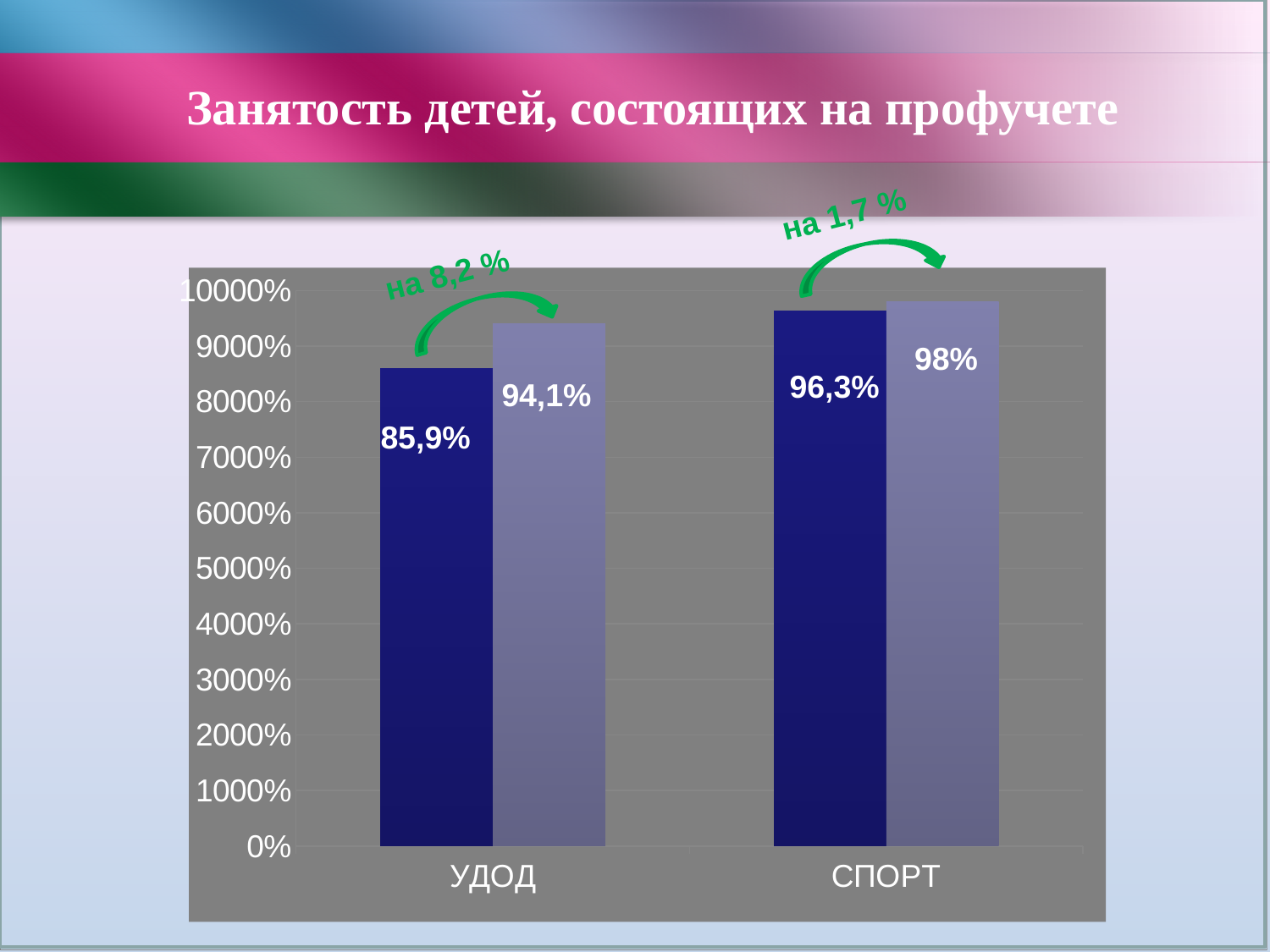
What value is labelled on the light purple bar for СПОРТ? 98% Which category has the higher dark blue bar, УДОД or СПОРТ? СПОРТ What value is labelled on the dark blue bar for УДОД? 85,9% What value is labelled on the light purple bar for УДОД? 94,1% By how much does the light purple bar exceed the dark blue bar for СПОРТ? 1,7% By how much does the light purple bar exceed the dark blue bar for УДОД? 8,2% What is the highest value labelled on the chart? 98% What type of chart is shown on the slide? Bar chart What is the title of the slide? Занятость детей, состоящих на профучете What is the lowest value labelled on the chart? 85,9% How many categories are shown on the x axis? 2 What value is labelled on the dark blue bar for СПОРТ? 96,3%